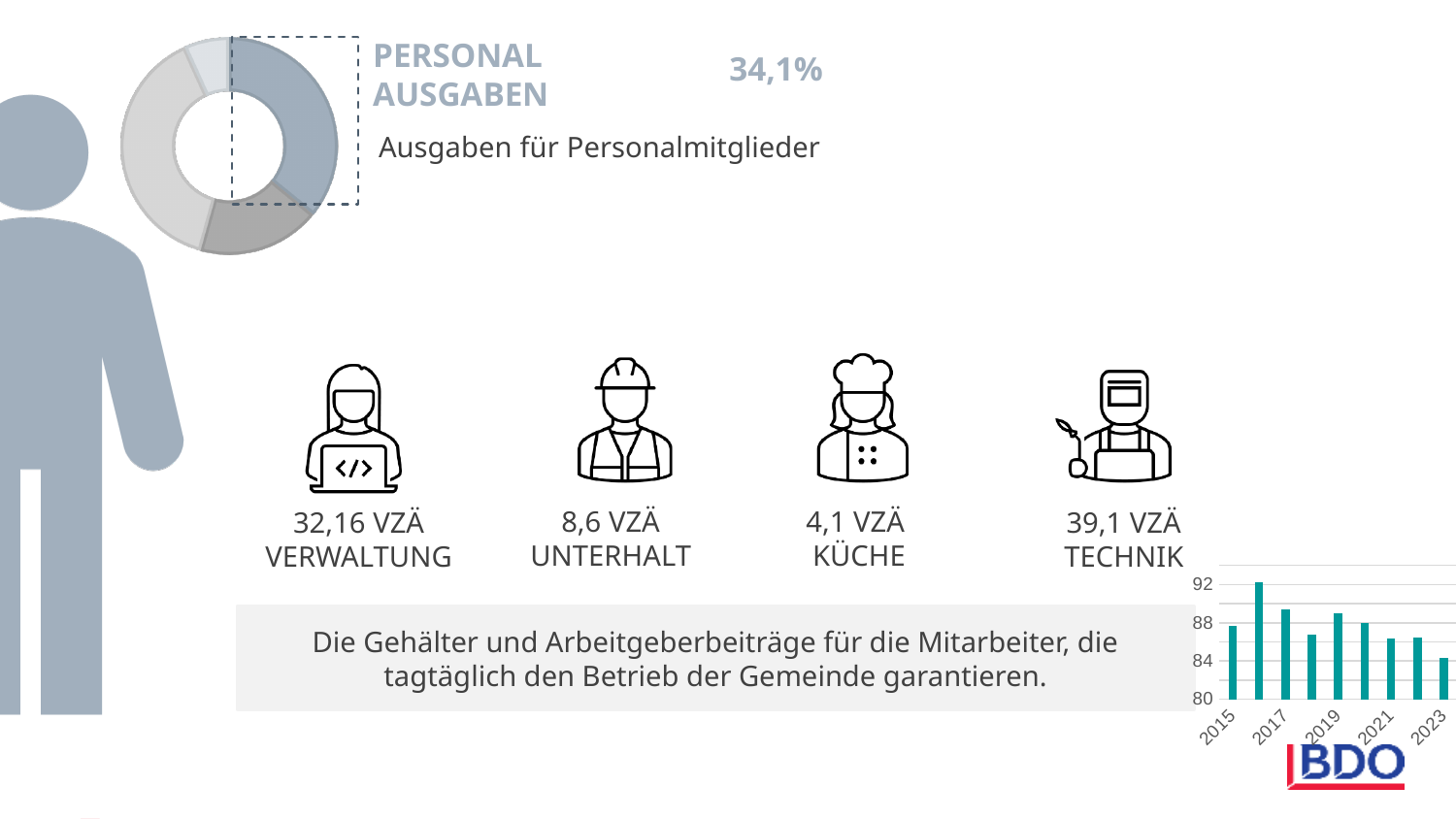
What kind of chart is shown at the bottom right of the slide? bar chart In the donut chart at the top left, what share is shown for the highlighted 'Personalausgaben' slice? 34,1% How many bars does the bar chart at the bottom right contain? 9 In the bar chart at the bottom right, which labelled year has the lowest value? 2023 In the bar chart at the bottom right, is the value for 2021 greater or less than 88? less In the bar chart at the bottom right, which is larger, the value for 2015 or the value for 2023? 2015 In the bar chart at the bottom right, do the values generally rise or fall from 2017 to 2023? fall What kind of chart is shown at the top left next to the 'Personalausgaben' label? donut (pie) chart In the bar chart at the bottom right, is the value for 2019 greater or less than 84? greater In the bar chart at the bottom right, is the value for 2023 greater or less than 88? less What is the first year labelled on the x axis of the bar chart at the bottom right? 2015